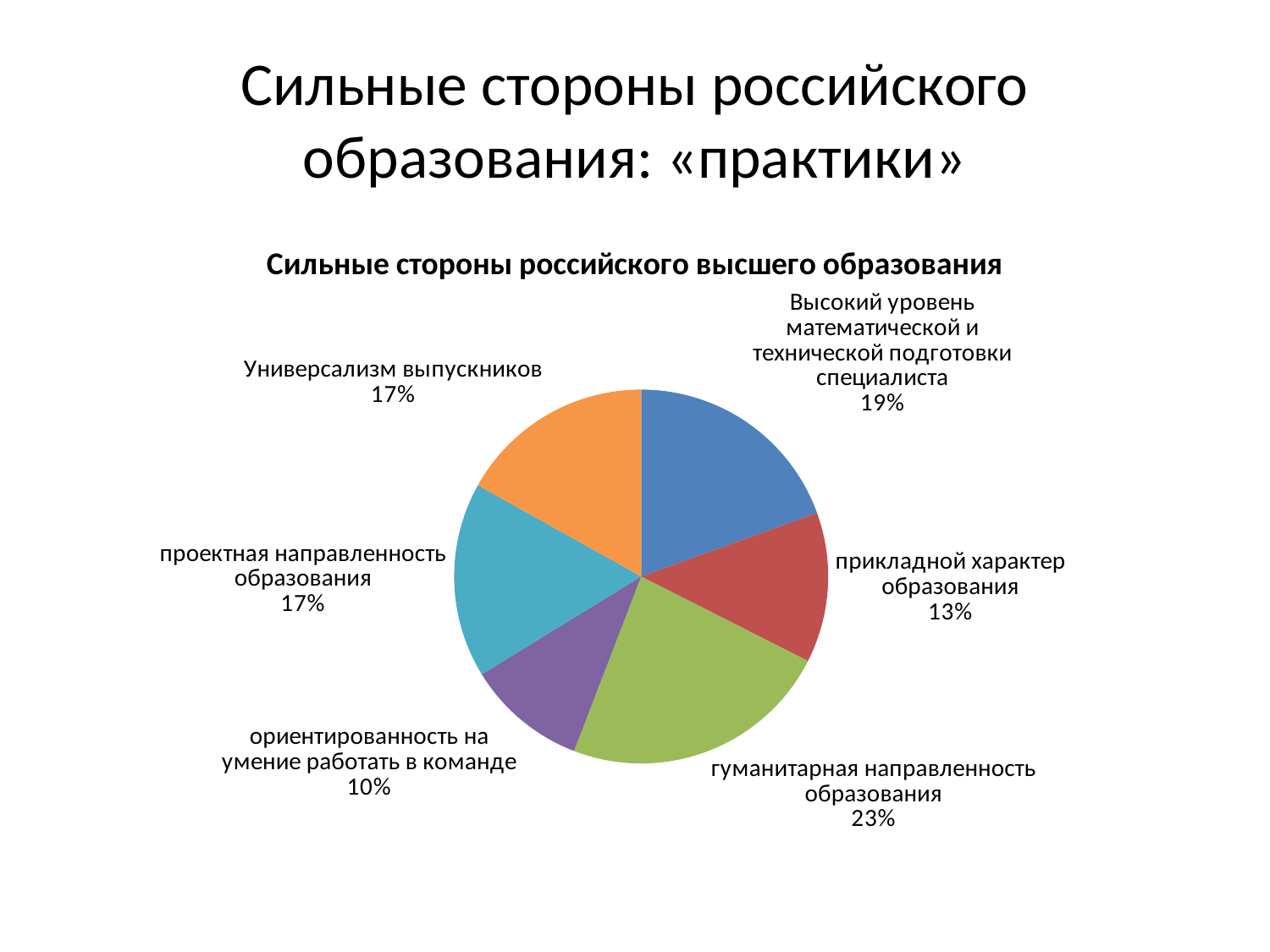
What share does "прикладной характер образования" have? 13% What share does "гуманитарная направленность образования" have? 23% What is the chart's title? Сильные стороны российского высшего образования What colour is the slice for "гуманитарная направленность образования"? green Which category has the largest share of the pie? гуманитарная направленность образования What kind of chart is shown on the slide? pie chart What share does "ориентированность на умение работать в команде" have? 10% How many slices does the pie chart have? 6 Which is larger: the share for "Универсализм выпускников" or the share for "прикладной характер образования"? Универсализм выпускников Which category has the smallest share of the pie? ориентированность на умение работать в команде What is the difference in percentage points between "гуманитарная направленность образования" and "прикладной характер образования"? 10 What share does "Высокий уровень математической и технической подготовки специалиста" have? 19%